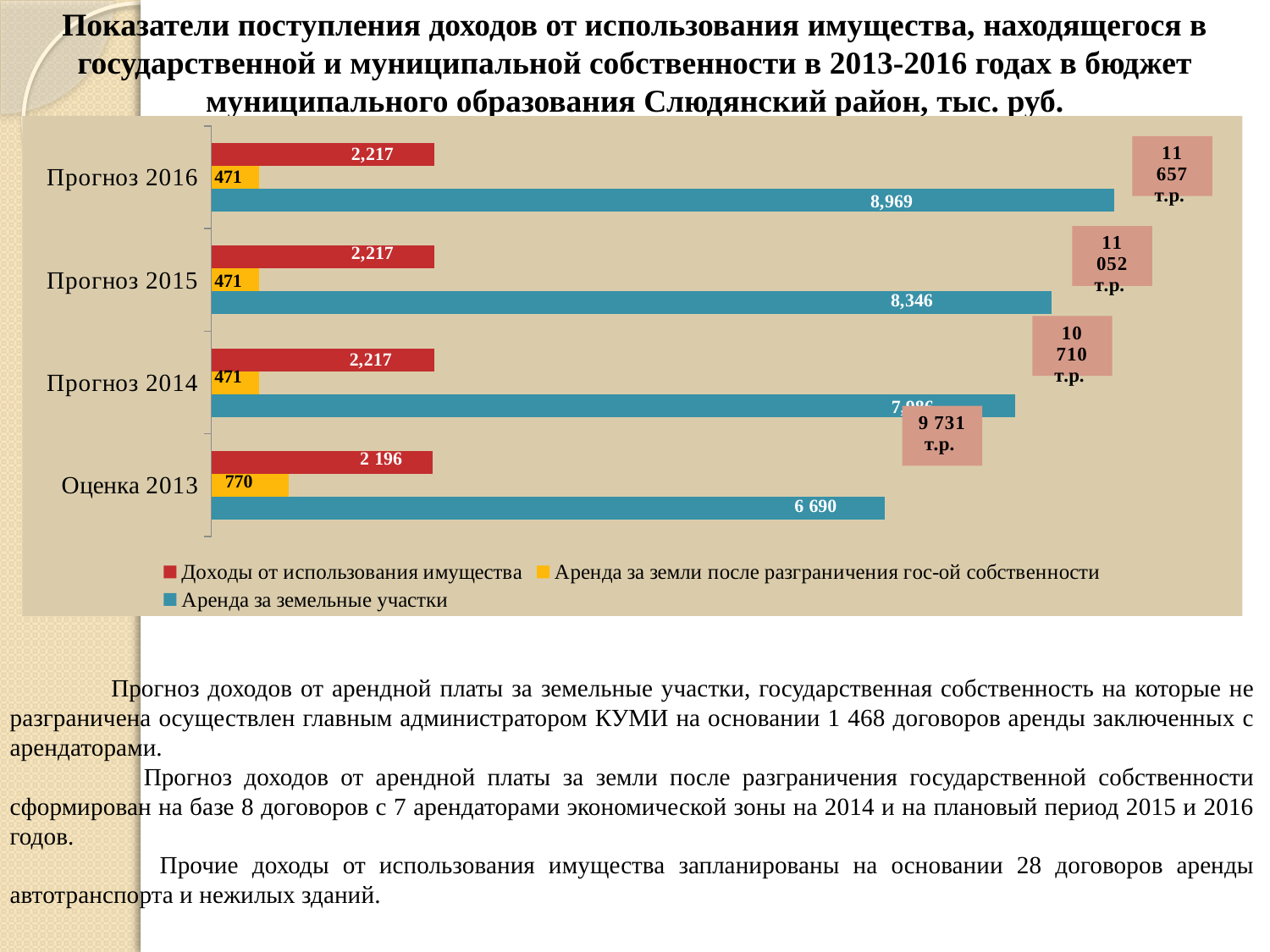
What is the difference between the Аренда за земли после разграничения гос-ой собственности values for Оценка 2013 and Прогноз 2014? 299 What is the value of Аренда за земельные участки for Прогноз 2016? 8,969 Which category has the highest value for Аренда за земельные участки? Прогноз 2016 What is the value of Доходы от использования имущества for Оценка 2013? 2 196 What is the value of Аренда за земли после разграничения гос-ой собственности for Оценка 2013? 770 Which category has the lowest value for Аренда за земельные участки? Оценка 2013 What is the difference between the Аренда за земельные участки values for Прогноз 2016 and Прогноз 2015? 623 Which is larger: Аренда за земельные участки for Оценка 2013 or for Прогноз 2014? Прогноз 2014 What is the value of Аренда за земельные участки for Прогноз 2015? 8,346 What kind of chart is shown on the slide? Bar chart How many categories (years) are shown on the chart? 4 How many series does the legend list? 3